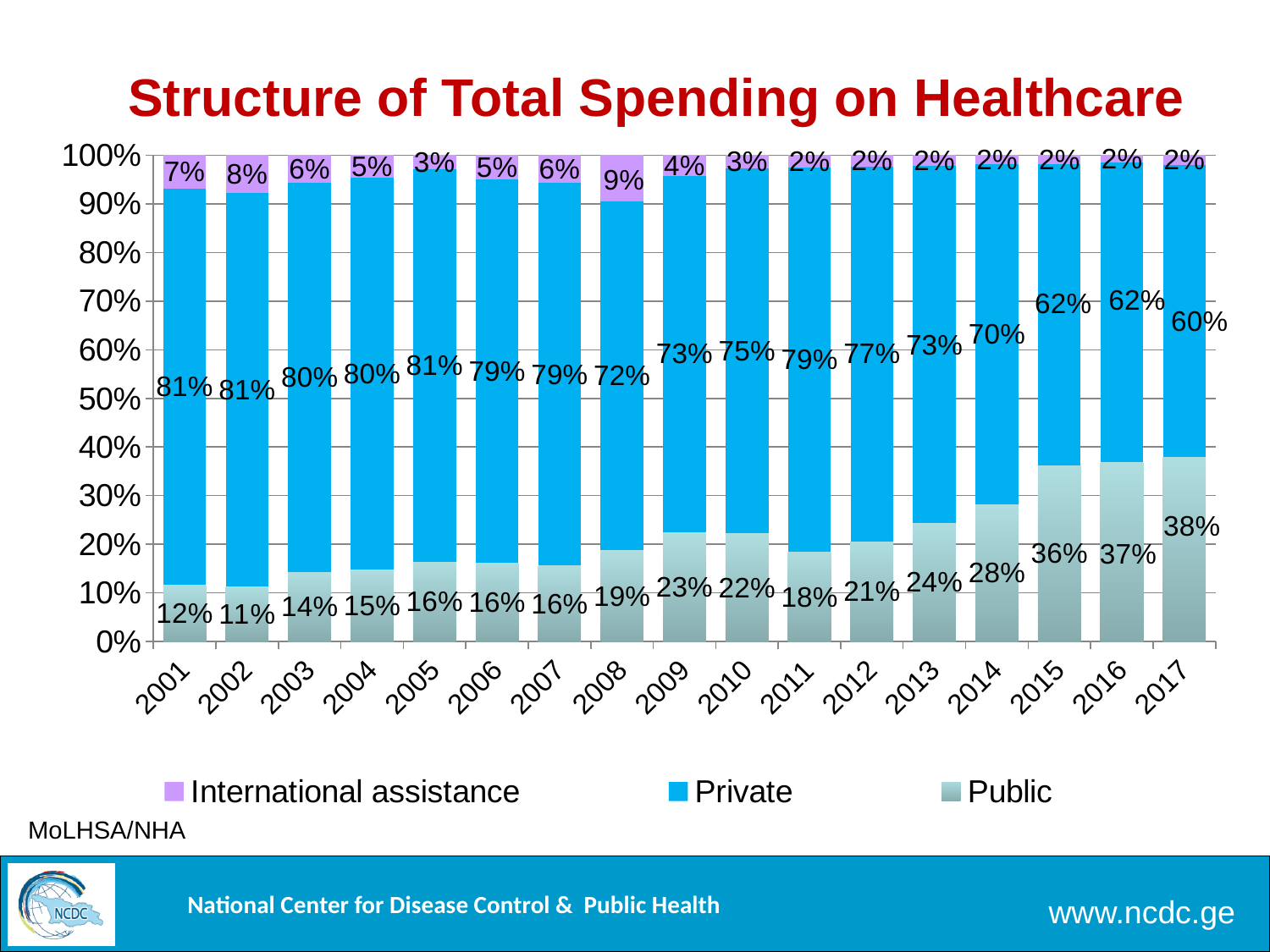
How many years are shown on the x axis? 17 What kind of chart is shown on the slide? Stacked bar chart In which year is the International assistance share the highest? 2008 How many series does the legend list? 3 What is the Public share of total healthcare spending in 2017? 38% What is the difference between the Public share in 2017 and in 2001? 26% In which year is the Public share the lowest? 2002 What is the Private share of total healthcare spending in 2008? 72% What is the International assistance share in 2002? 8% Which is larger, the Public share in 2009 or in 2010? 2009 Does the Public share generally rise or fall from 2001 to 2017? Rise In which year is the Private share the lowest? 2017